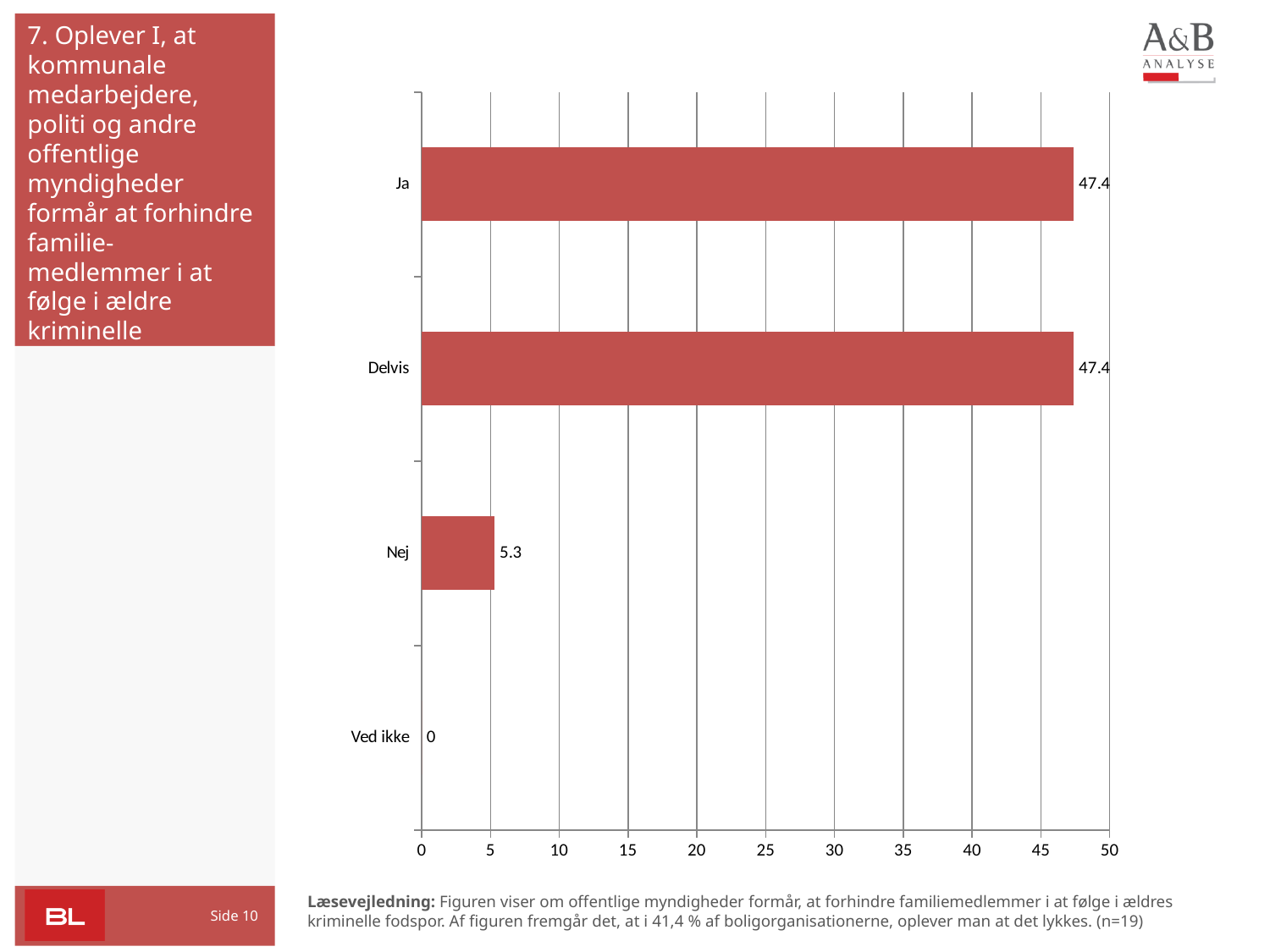
Is the value for "Nej" greater or less than 10? less What is the difference between the values for "Ja" and "Nej"? 42.1 Which category has the lowest value? Ved ikke Which is larger, the value for "Delvis" or the value for "Nej"? Delvis Is the value for "Ja" greater or less than 45? greater What is the value for "Delvis"? 47.4 How many categories are shown in the chart? 4 What is the value for "Ja"? 47.4 What is the difference between the values for "Delvis" and "Ved ikke"? 47.4 What is the value for "Ved ikke"? 0 What is the value for "Nej"? 5.3 What kind of chart is shown on the slide? bar chart